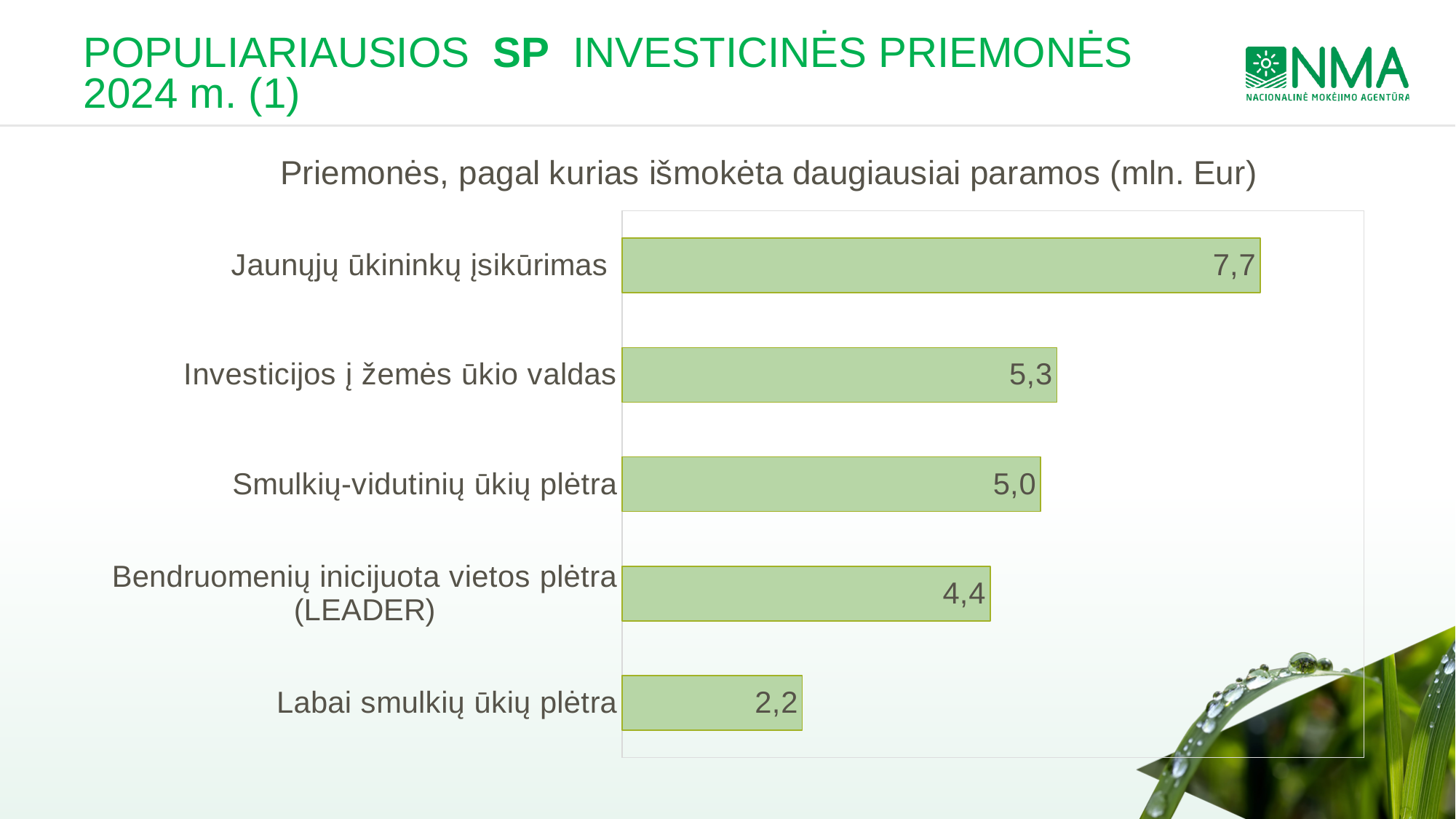
What is the difference between the values for Bendruomenių inicijuota vietos plėtra (LEADER) and Labai smulkių ūkių plėtra? 2,2 Which category has the lowest value? Labai smulkių ūkių plėtra What is the difference between the values for Jaunųjų ūkininkų įsikūrimas and Investicijos į žemės ūkio valdas? 2,4 What is the value for Labai smulkių ūkių plėtra? 2,2 What is the value for Smulkių-vidutinių ūkių plėtra? 5,0 What kind of chart is shown on the slide? Bar chart Which category has the highest value? Jaunųjų ūkininkų įsikūrimas Which is larger, the value for Investicijos į žemės ūkio valdas or the value for Smulkių-vidutinių ūkių plėtra? Investicijos į žemės ūkio valdas What is the value for Jaunųjų ūkininkų įsikūrimas? 7,7 What is the value for Bendruomenių inicijuota vietos plėtra (LEADER)? 4,4 What is the title of the chart? Priemonės, pagal kurias išmokėta daugiausiai paramos (mln. Eur) How many categories are shown in the chart? 5